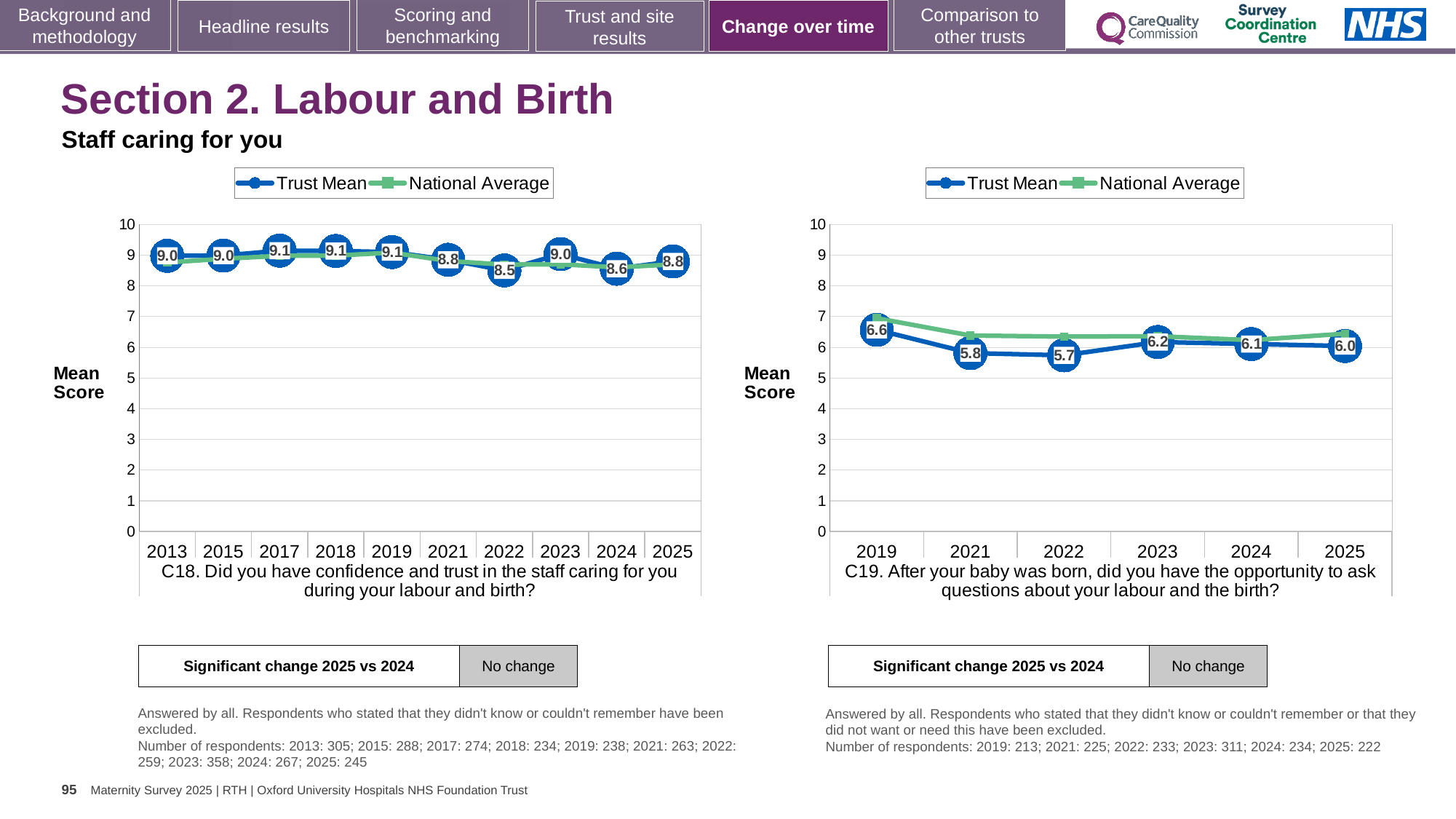
In the left chart (C18), how many years are shown on the x axis? 10 How many series does the legend of the right chart (C19) list? 2 In the left chart (C18), which year has the lowest Trust Mean? 2022 In the right chart (C19), what is the Trust Mean for 2022? 5.7 In the right chart (C19), is the National Average for 2019 greater or less than 6? greater In the right chart (C19), what is the Trust Mean for 2019? 6.6 In the left chart (C18), what is the Trust Mean for 2025? 8.8 In the right chart (C19), which year has the highest Trust Mean? 2019 In the right chart (C19), is the Trust Mean for 2021 higher or lower than for 2023? lower In the left chart (C18), what is the difference between the Trust Mean for 2023 and 2024? 0.4 In the left chart (C18), what is the Trust Mean for 2022? 8.5 What type of chart is the left chart (C18)? Line chart